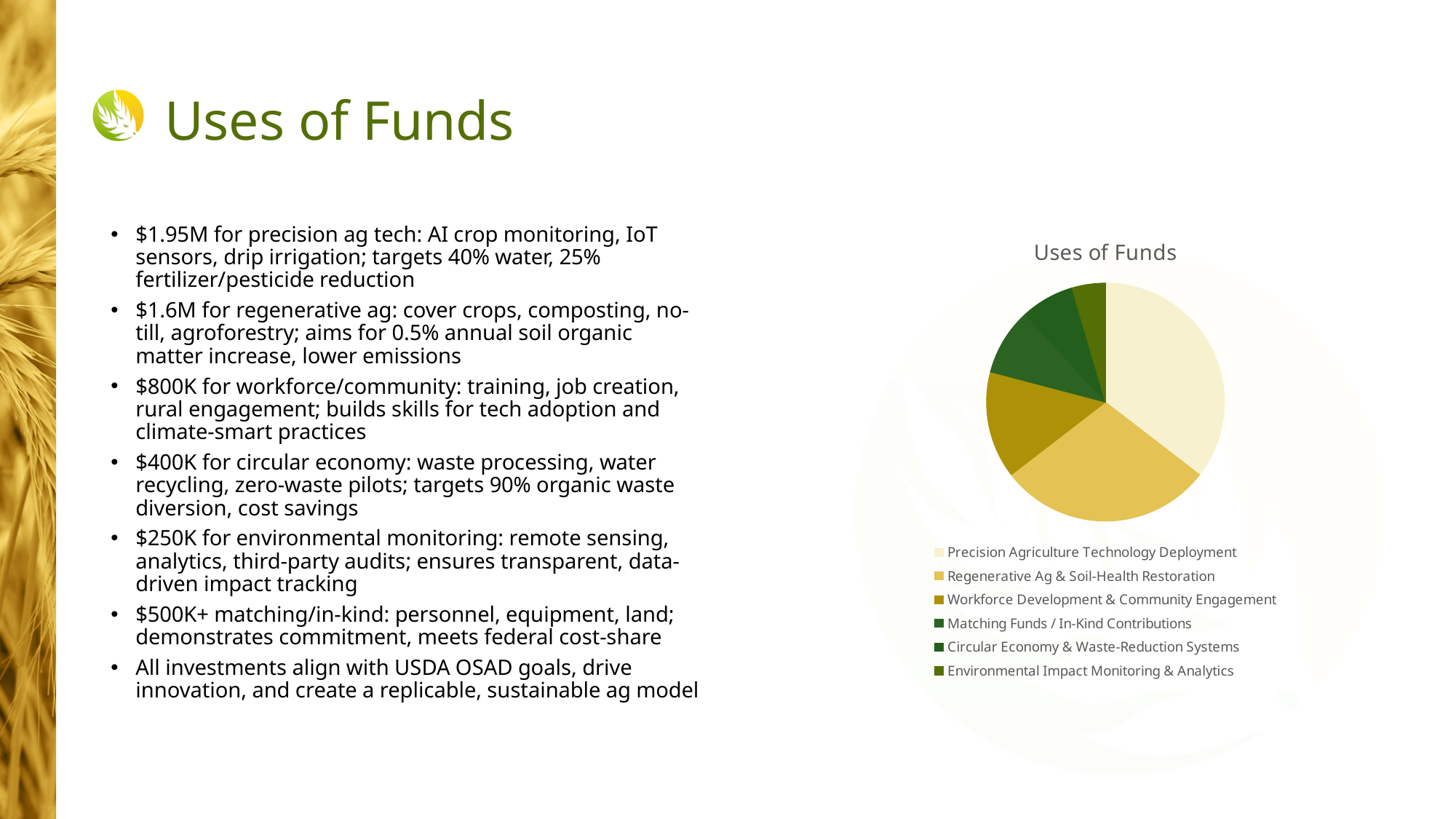
Which legend entry is listed first in the pie chart's legend? Precision Agriculture Technology Deployment What is the title of the chart? Uses of Funds Which slice is larger: Workforce Development & Community Engagement or Environmental Impact Monitoring & Analytics? Workforce Development & Community Engagement Which category has the smallest slice of the pie? Environmental Impact Monitoring & Analytics What kind of chart is shown on the slide? Pie chart Which category has the largest slice of the pie? Precision Agriculture Technology Deployment Which slice is larger: Precision Agriculture Technology Deployment or Regenerative Ag & Soil-Health Restoration? Precision Agriculture Technology Deployment Which slice is larger: Regenerative Ag & Soil-Health Restoration or Workforce Development & Community Engagement? Regenerative Ag & Soil-Health Restoration How many categories does the pie chart's legend list? 6